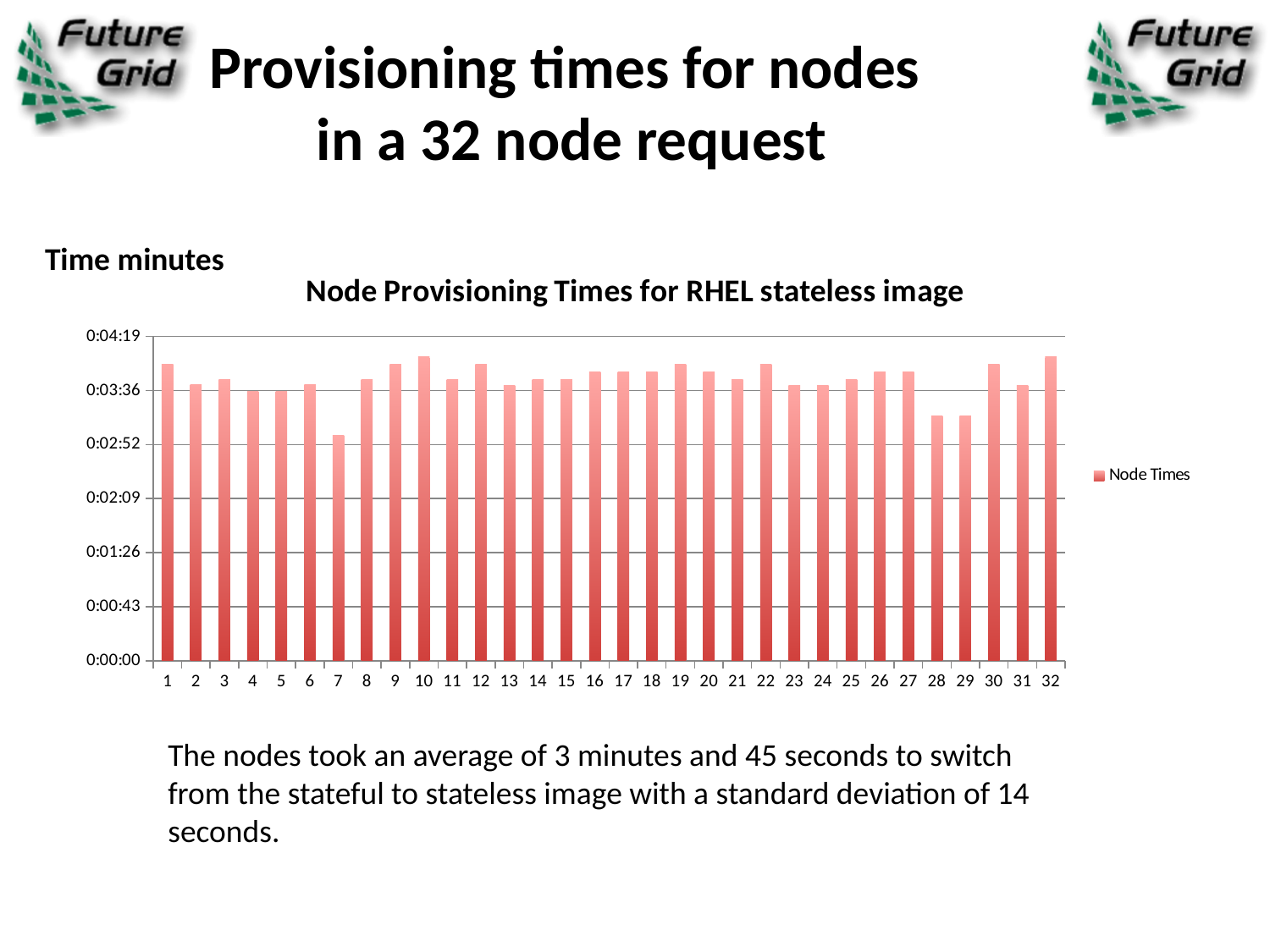
Is the value for node 1 greater or less than 0:03:36? greater How many nodes (categories) are plotted along the x axis? 32 How many series does the legend list? 1 Which node has the lowest provisioning time? 7 Which has the larger provisioning time, node 10 or node 29? Node 10 Is the value for node 7 greater or less than 0:02:52? greater What kind of chart is shown on the slide? Bar chart What is the title of the chart? Node Provisioning Times for RHEL stateless image Which has the larger provisioning time, node 1 or node 7? Node 1 What is the name of the series shown in the legend? Node Times Is the value for node 7 greater or less than 0:03:36? less